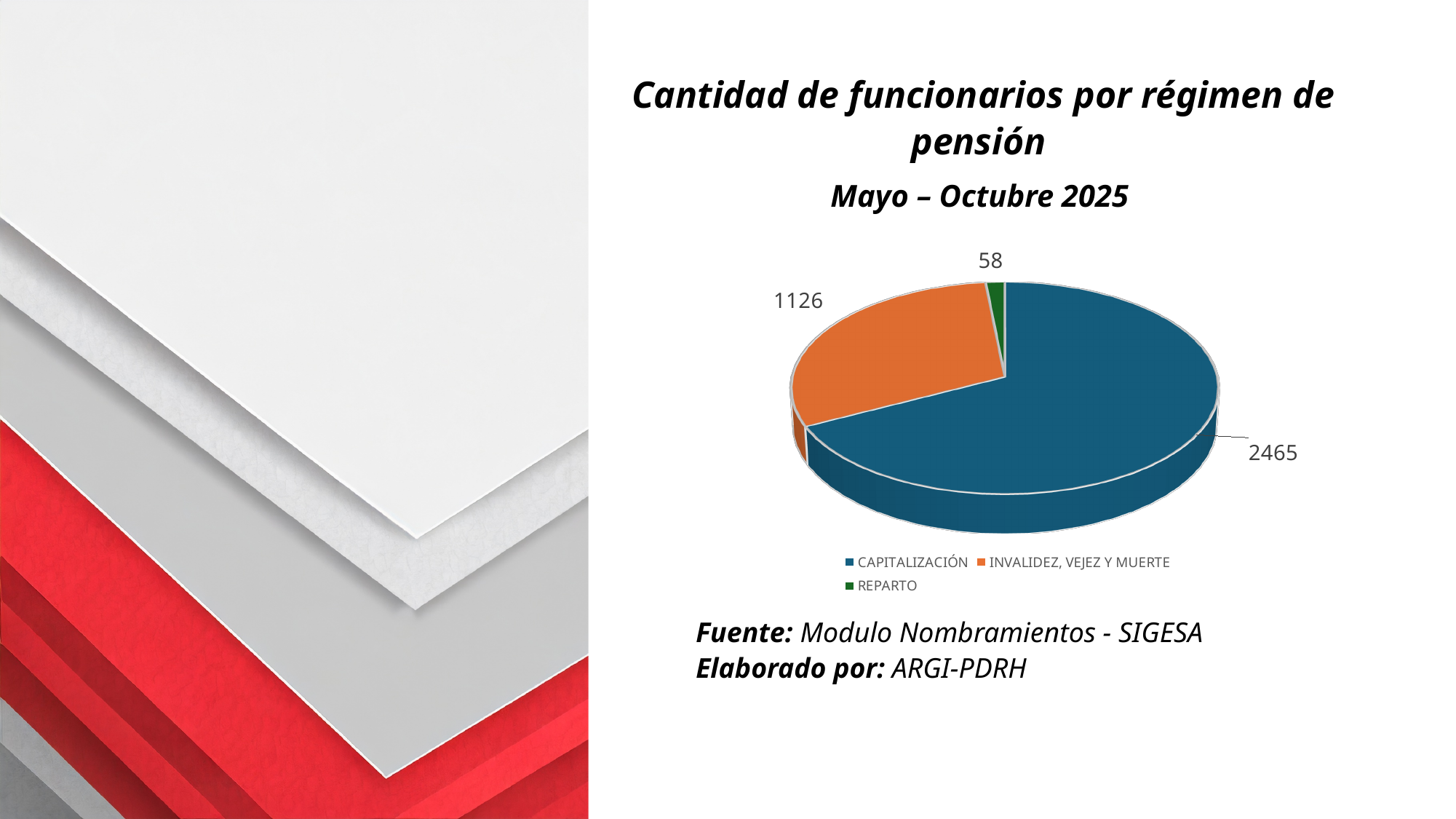
What is the difference between the values for CAPITALIZACIÓN and INVALIDEZ, VEJEZ Y MUERTE? 1339 What is the value for INVALIDEZ, VEJEZ Y MUERTE? 1126 What is the difference between the values for INVALIDEZ, VEJEZ Y MUERTE and REPARTO? 1068 What kind of chart is shown on the slide? Pie chart How many categories does the pie chart show? 3 Which pension regime has the highest number of funcionarios? CAPITALIZACIÓN Which is larger, the value for INVALIDEZ, VEJEZ Y MUERTE or the value for REPARTO? INVALIDEZ, VEJEZ Y MUERTE Which pension regime has the lowest number of funcionarios? REPARTO What is the total of all slices in the pie chart? 3649 What colour is the slice for REPARTO? Green What is the value for REPARTO? 58 What is the value for CAPITALIZACIÓN? 2465